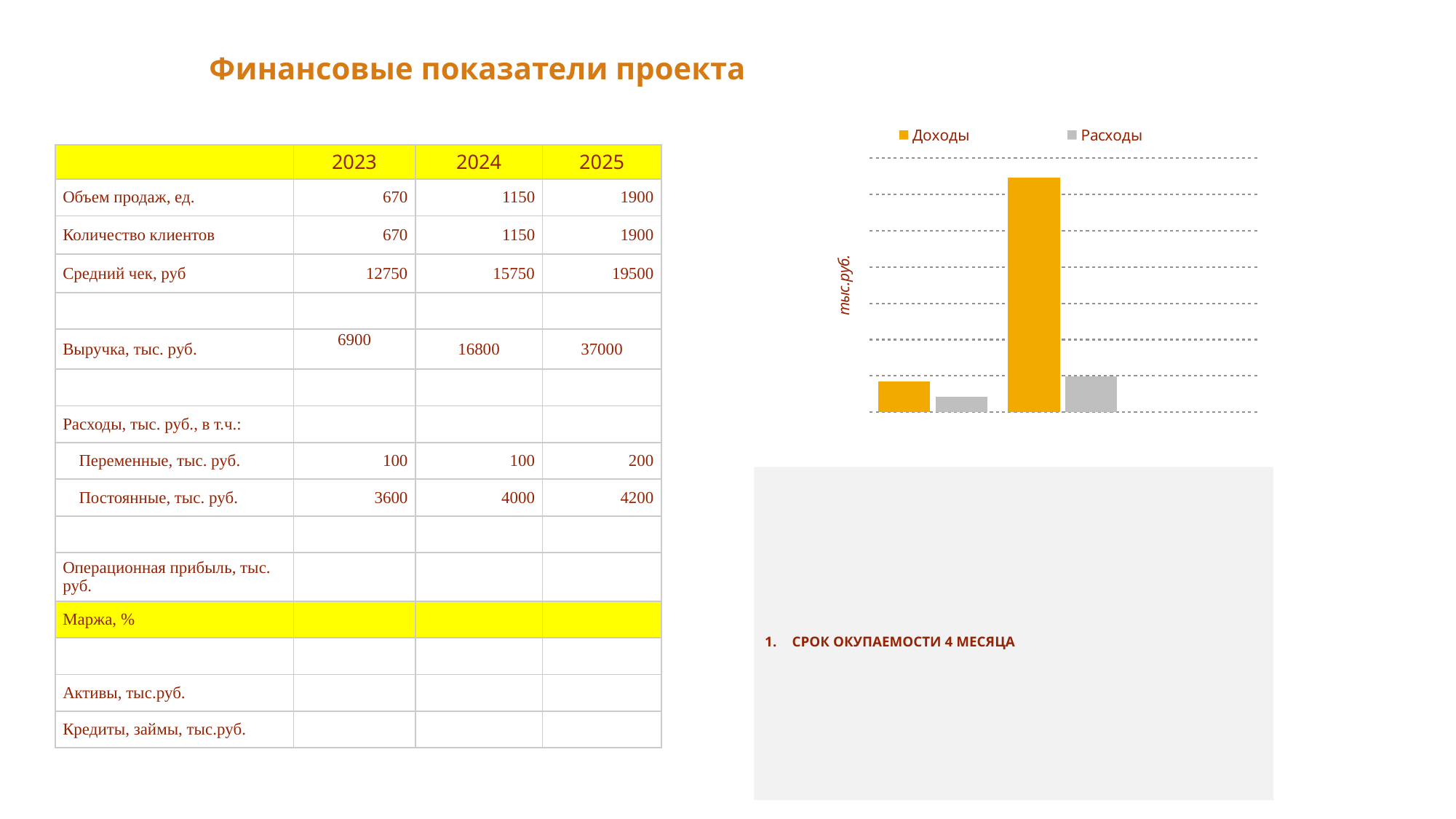
How many groups of bars are plotted in the chart? 2 How many series does the chart legend list? 2 What are the two series named in the chart legend? Доходы and Расходы Does the Расходы series rise or fall from the first group of bars to the second? rise Does the Доходы series rise or fall from the first group of bars to the second? rise What is the label on the vertical axis of the chart? тыс.руб. In the second (right-hand) group of bars, which series has the taller bar, Доходы or Расходы? Доходы Which of the two Доходы bars is the tallest, the one in the first group or the one in the second group? the second group Which bar in the chart is the shortest overall? Расходы in the first group What kind of chart is shown on the right of the slide? bar chart In the first (left-hand) group of bars, which series has the taller bar, Доходы or Расходы? Доходы